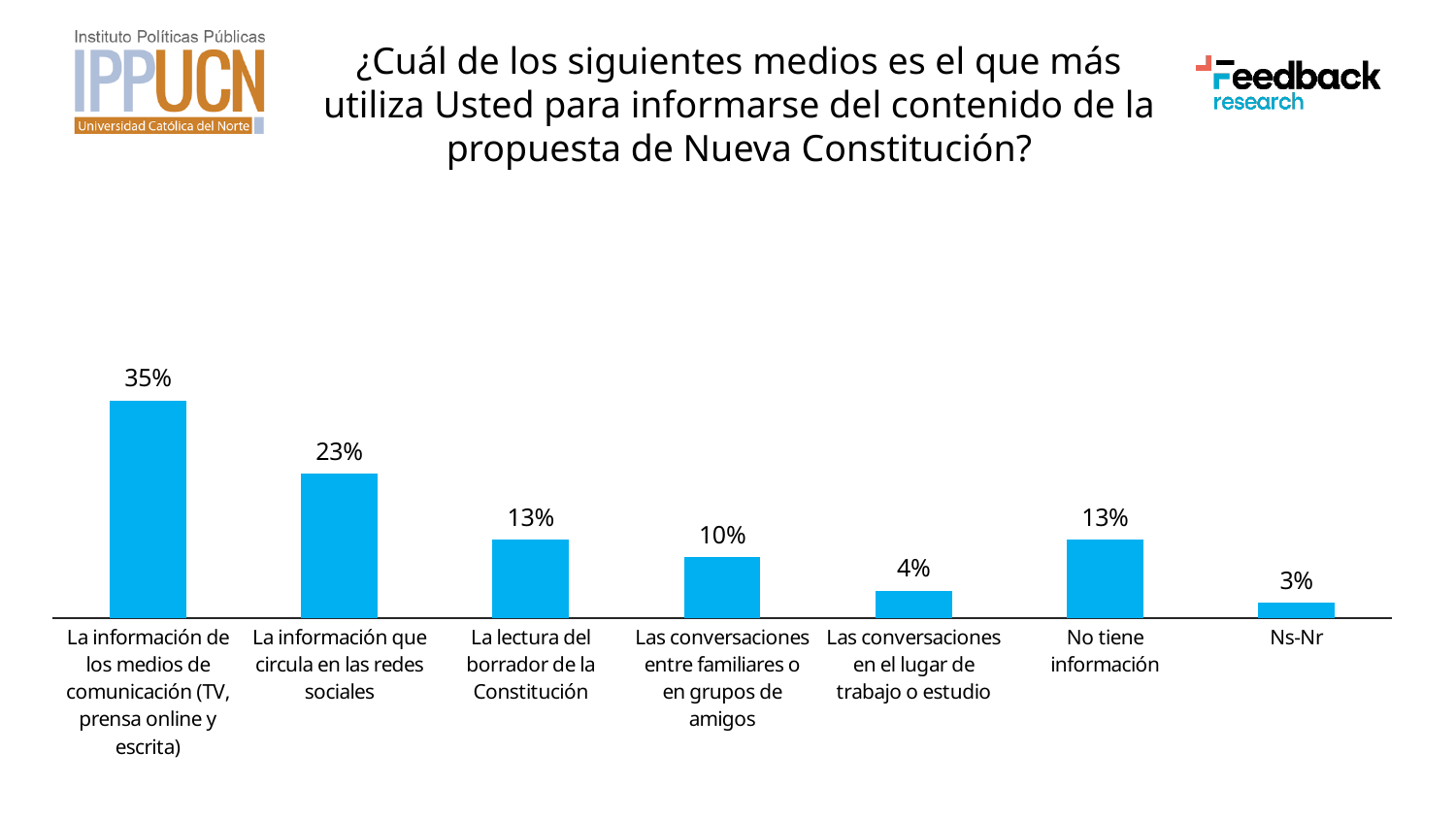
What is the value for "La información que circula en las redes sociales"? 23% What is the difference between the values for "La información de los medios de comunicación" and "La información que circula en las redes sociales"? 12% Which category has the highest value? La información de los medios de comunicación (TV, prensa online y escrita) What is the value for "Ns-Nr"? 3% Which is larger: the value for "Las conversaciones entre familiares o en grupos de amigos" or the value for "No tiene información"? No tiene información What is the difference between the values for "La lectura del borrador de la Constitución" and "Ns-Nr"? 10% What is the value for "La información de los medios de comunicación (TV, prensa online y escrita)"? 35% What is the value for "Las conversaciones en el lugar de trabajo o estudio"? 4% How many categories are shown in the chart? 7 What kind of chart is shown on the slide? Bar chart What colour are the bars in the chart? Blue Which category has the lowest value? Ns-Nr